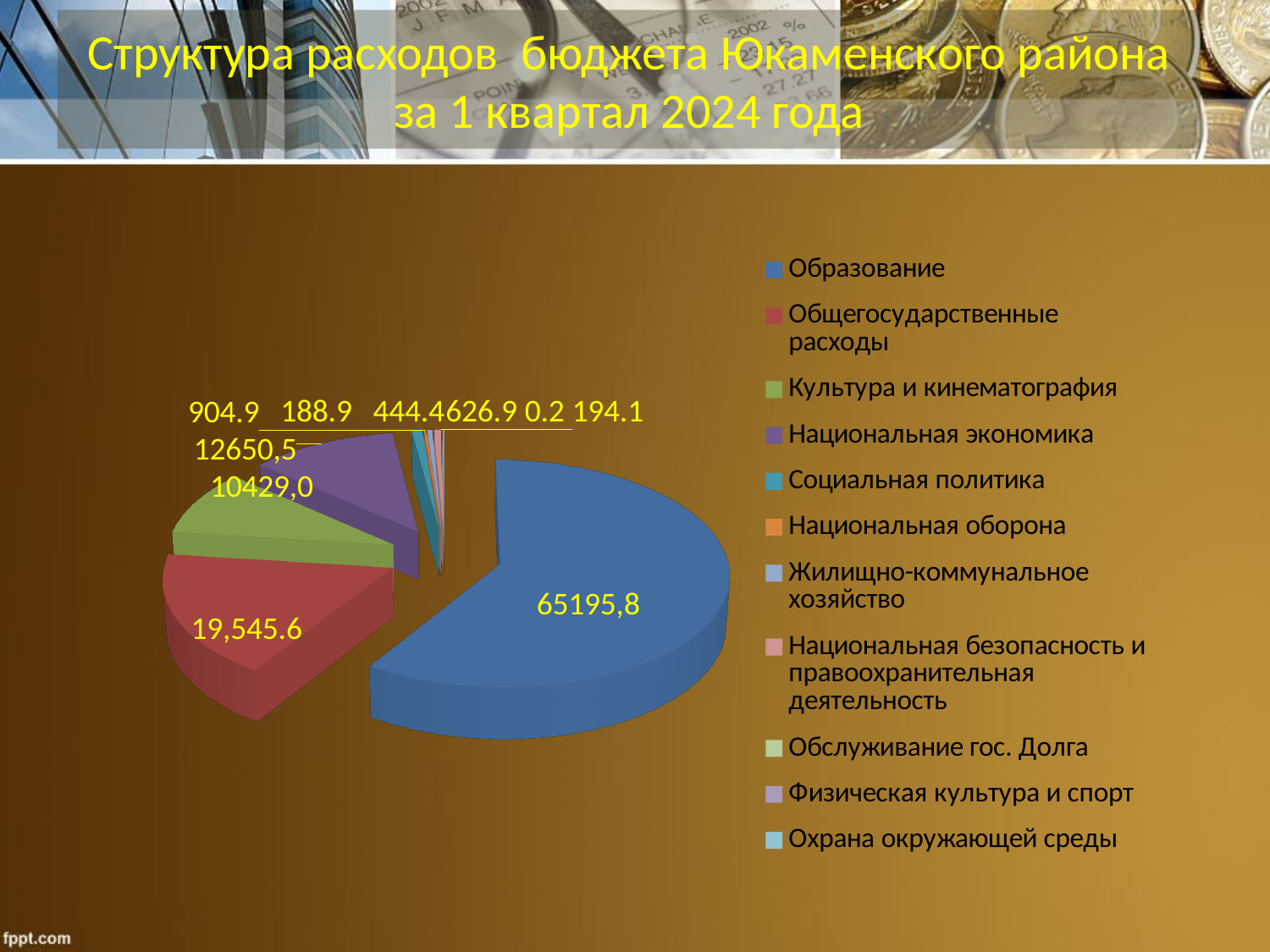
What is the value shown for Культура и кинематография? 10429,0 What is the value shown for Национальная экономика? 12650,5 What is the difference between the values for Национальная экономика and Культура и кинематография? 2221,5 What colour is the slice for Образование? blue How many categories does the legend of the pie chart list? 11 What is the value shown for Образование? 65195,8 What is the title of the slide's chart? Структура расходов бюджета Юкаменского района за 1 квартал 2024 года What is the value shown for Общегосударственные расходы? 19,545.6 Which is larger, the value for Национальная экономика or the value for Культура и кинематография? Национальная экономика What kind of chart is shown on the slide? pie chart Which is larger, the value for Общегосударственные расходы or the value for Национальная экономика? Общегосударственные расходы Which category has the largest slice of the pie? Образование